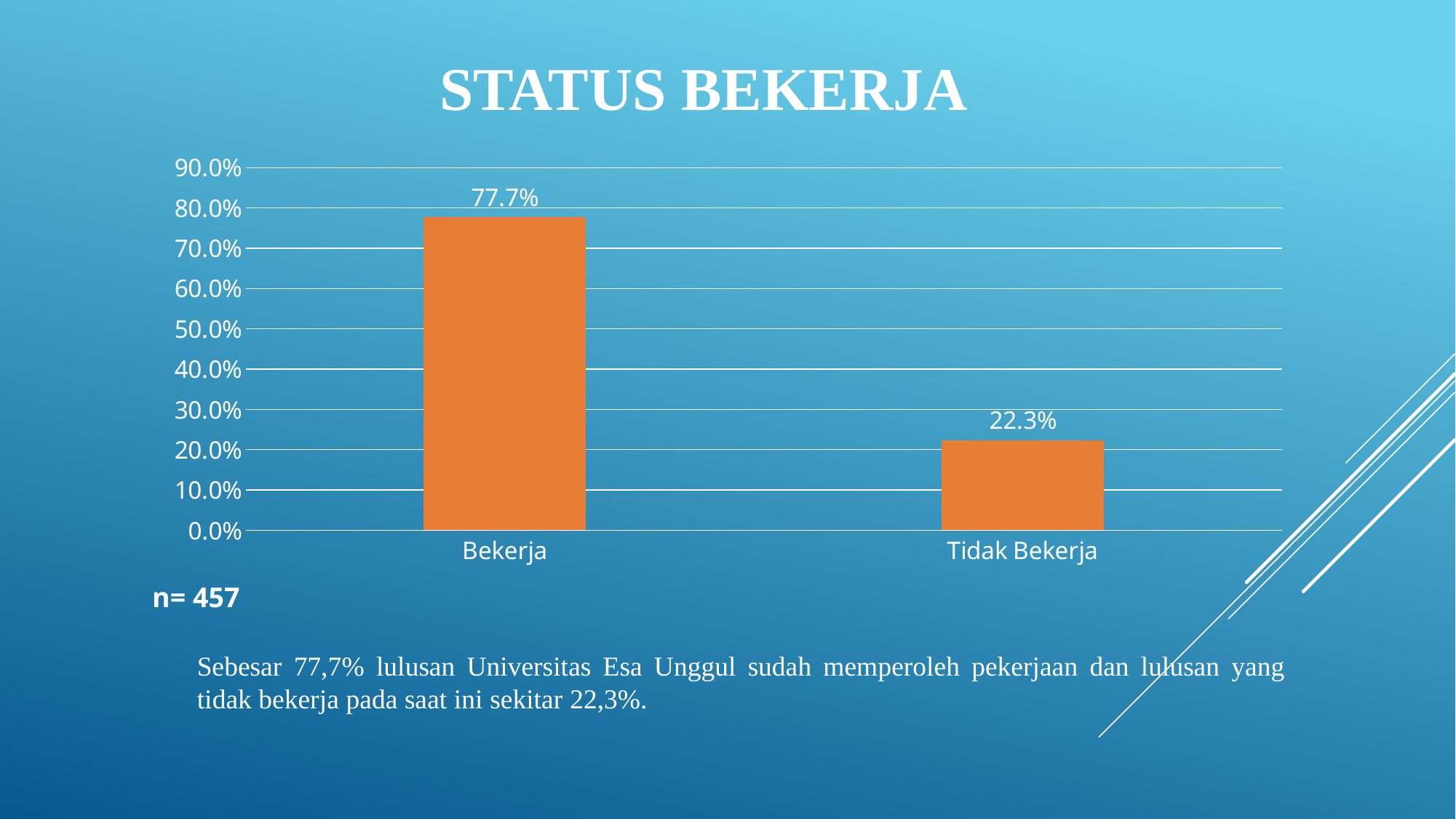
Which category has the highest value? Bekerja How many categories are shown on the x axis? 2 Which is larger, the value for Bekerja or the value for Tidak Bekerja? Bekerja What kind of chart is shown on the slide? bar chart Which category has the lowest value? Tidak Bekerja What is the title of the slide containing the chart? STATUS BEKERJA Is the value for Tidak Bekerja greater or less than 30.0%? less What is the highest value shown on the y axis? 90.0% What is the difference between the values for Bekerja and Tidak Bekerja? 55.4% What is the value for Tidak Bekerja? 22.3% What is the value for Bekerja? 77.7% Is the value for Bekerja greater or less than 70.0%? greater